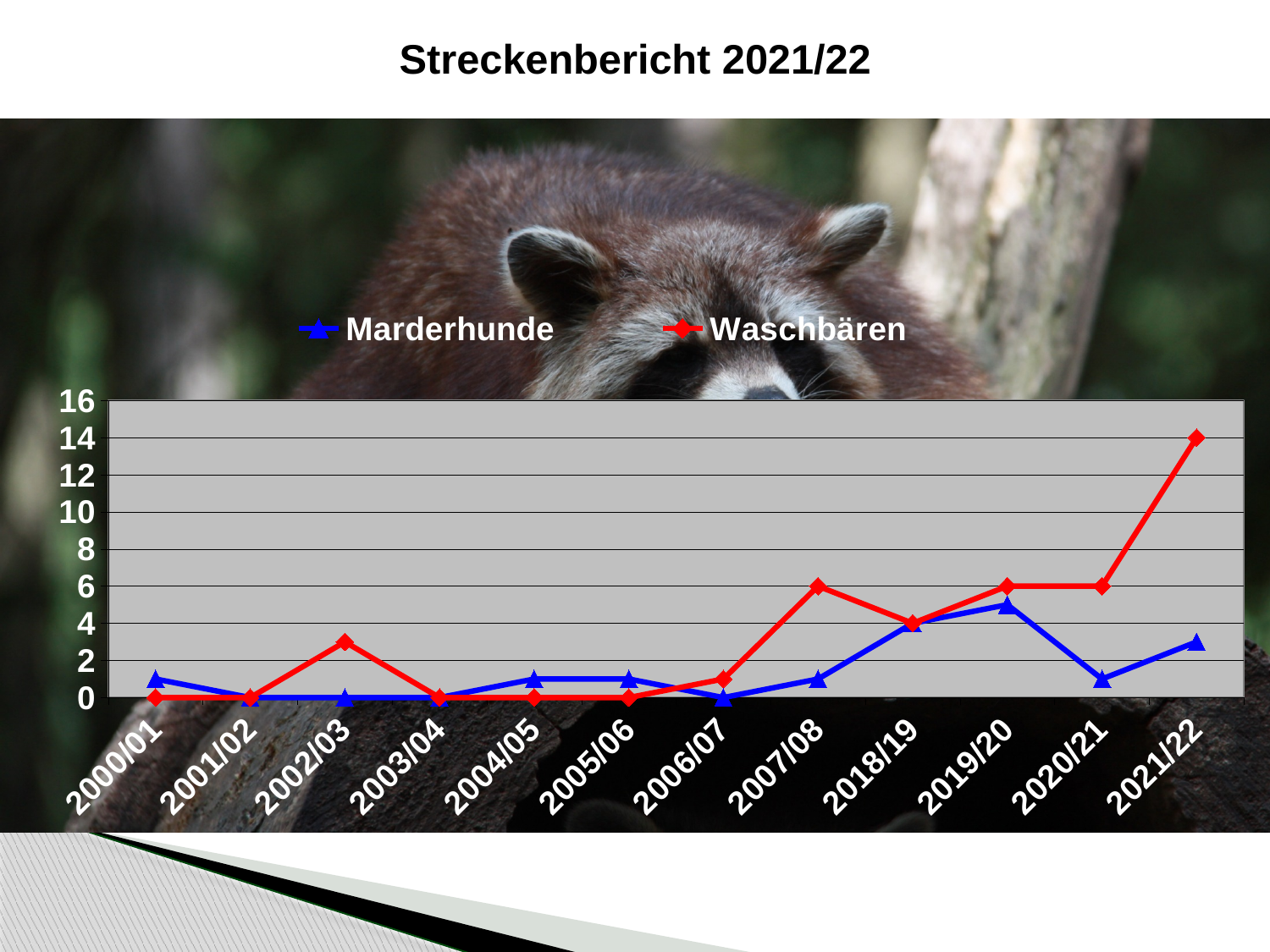
By how much did the Waschbären value increase from 2020/21 to 2021/22? 8 In which season is the Waschbären value highest? 2021/22 In which season is the Marderhunde value highest? 2019/20 Is the value for Waschbären in 2002/03 greater or less than 2? greater What is the value for Marderhunde in 2018/19? 4 What is the value for Waschbären in 2007/08? 6 What is the value for Waschbären in 2021/22? 14 How many seasons are shown on the x axis? 12 How many series does the legend list? 2 What kind of chart is shown on the slide? line chart In 2021/22, which series has the larger value, Marderhunde or Waschbären? Waschbären Is the value for Marderhunde in 2019/20 greater or less than 4? greater